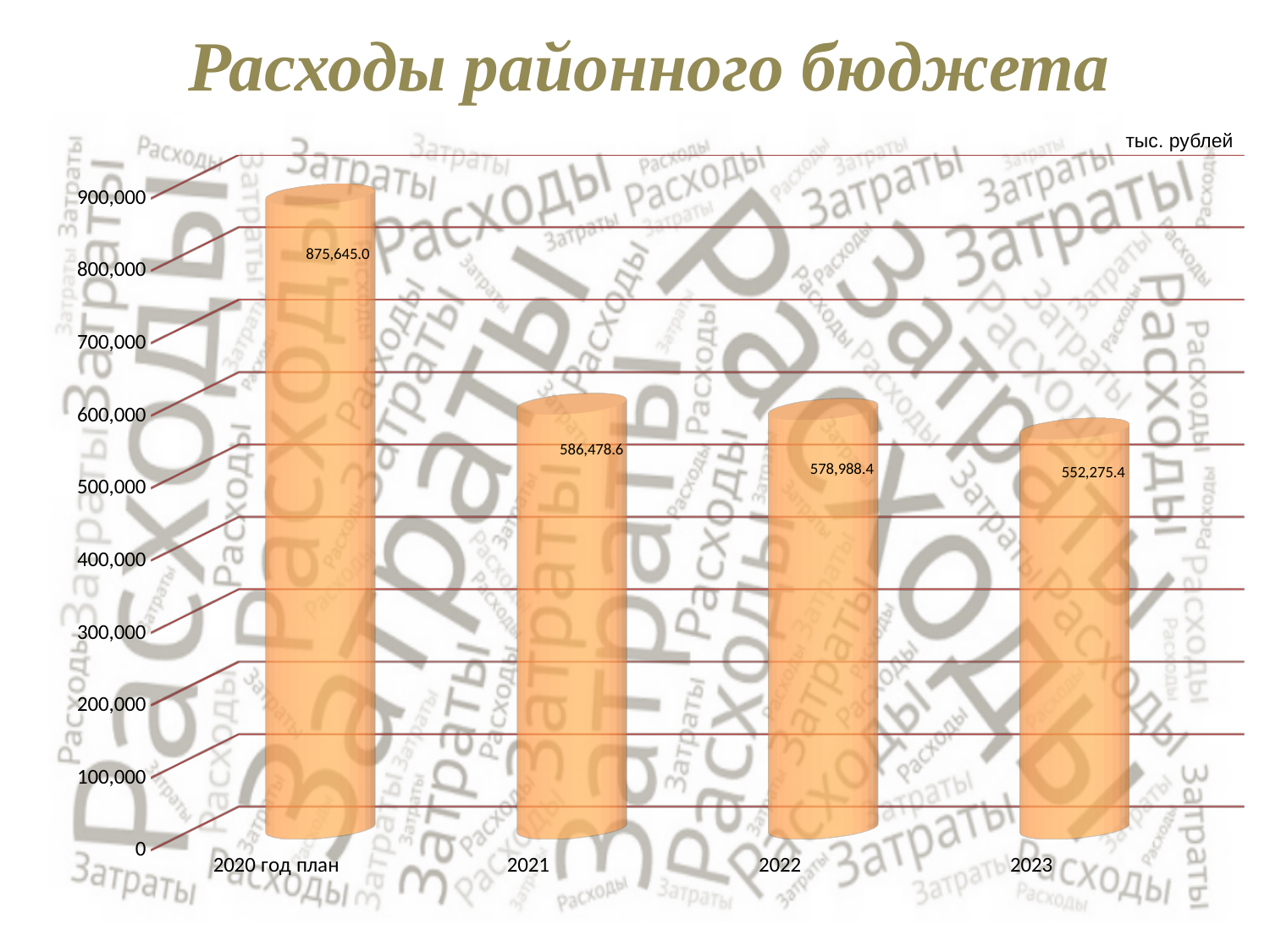
Which category has the highest value? 2020 год план What is the value for 2022? 578,988.4 Which category has the lowest value? 2023 What is the value for 2021? 586,478.6 What is the difference between the values for 2022 and 2023? 26,713.0 Which is larger, the value for 2021 or the value for 2022? 2021 Is the value for 2023 greater or less than 500,000? greater What is the difference between the values for 2020 год план and 2021? 289,166.4 What is the value for 2020 год план? 875,645.0 Do the values rise or fall from 2020 год план to 2023? fall How many categories are shown on the x axis? 4 What is the value for 2023? 552,275.4